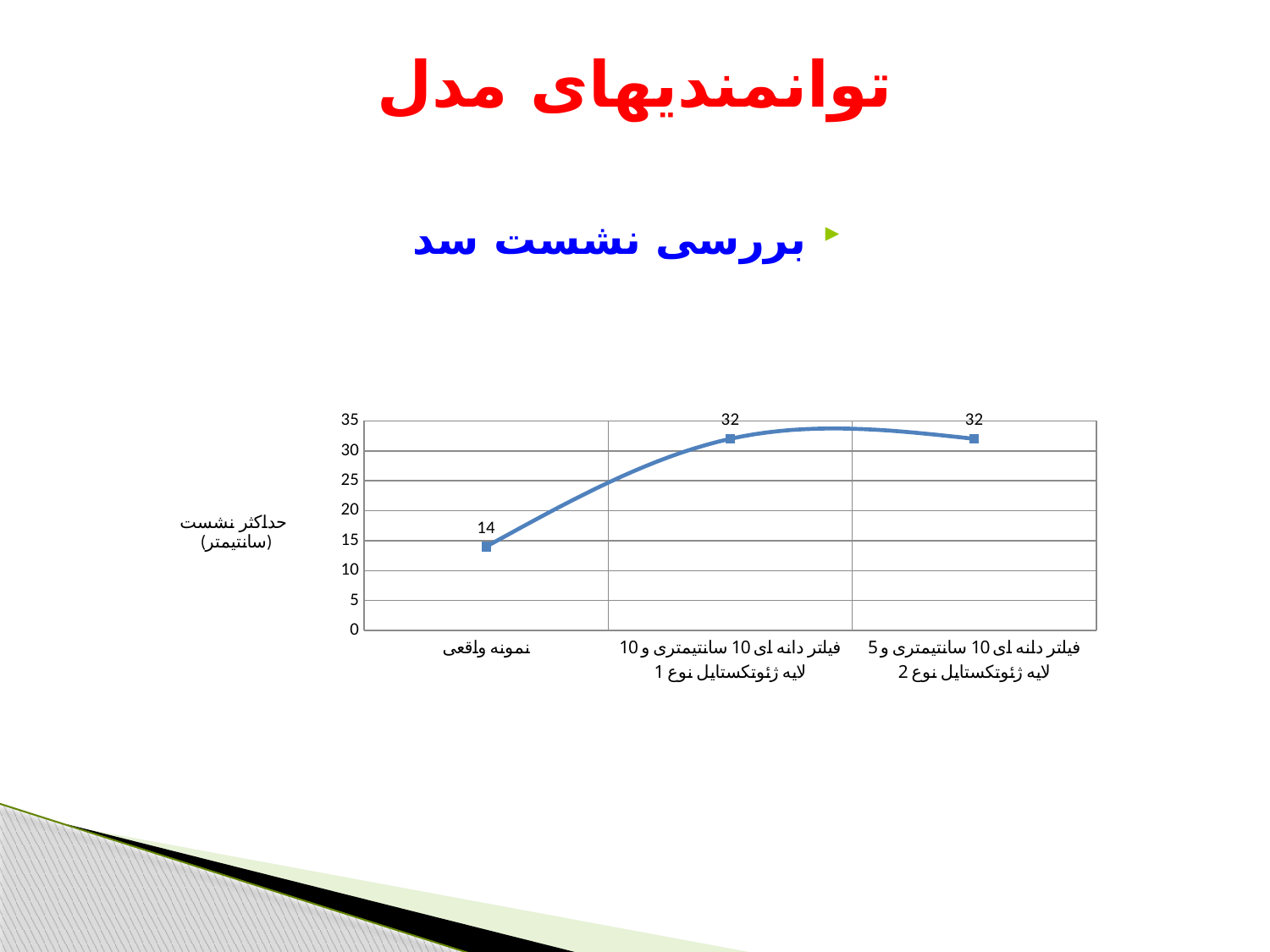
How many categories are plotted on the x axis? 3 What is the difference between the value for فیلتر دانه ای 10 سانتیمتری و 10 لایه ژئوتکستایل نوع 1 and the value for نمونه واقعی? 18 What is the value for نمونه واقعی? 14 What is the value for فیلتر دانه ای 10 سانتیمتری و 10 لایه ژئوتکستایل نوع 1? 32 What is the label on the vertical axis of the chart? حداکثر نشست (سانتیمتر) Does the value rise or fall from نمونه واقعی to فیلتر دانه ای 10 سانتیمتری و 10 لایه ژئوتکستایل نوع 1? rise What kind of chart is shown on the slide? line chart Is the value for فیلتر دانه ای 10 سانتیمتری و 10 لایه ژئوتکستایل نوع 1 greater or less than 30? greater Which is larger, the value for نمونه واقعی or the value for فیلتر دانه ای 10 سانتیمتری و 5 لایه ژئوتکستایل نوع 2? فیلتر دانه ای 10 سانتیمتری و 5 لایه ژئوتکستایل نوع 2 What is the value for فیلتر دانه ای 10 سانتیمتری و 5 لایه ژئوتکستایل نوع 2? 32 Which category has the lowest value? نمونه واقعی Is the value for نمونه واقعی greater or less than 20? less